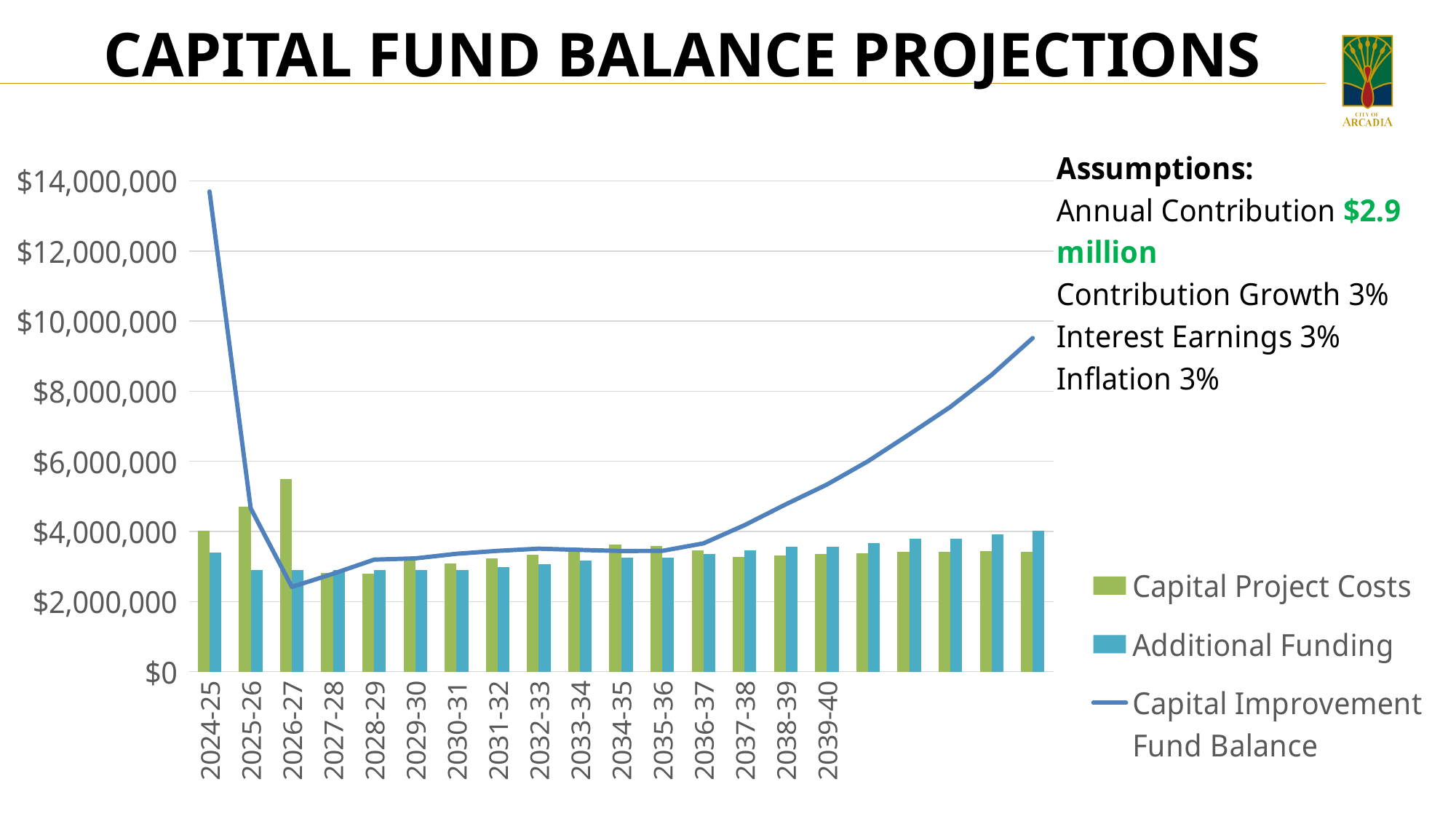
Is the Additional Funding value for 2025-26 greater or less than $4,000,000? less Which series is drawn as a line rather than bars? Capital Improvement Fund Balance Is the Capital Improvement Fund Balance for 2026-27 greater or less than $4,000,000? less How many series does the chart legend list? 3 What is the title of the chart on the slide? Capital Fund Balance Projections Is the Capital Project Costs value for 2026-27 greater or less than $4,000,000? greater What kind of chart is shown on the slide? A combined bar and line chart In 2025-26, which is larger: Capital Project Costs or Additional Funding? Capital Project Costs In which year are Capital Project Costs highest? 2026-27 In which year is the Capital Improvement Fund Balance lowest? 2026-27 Does the Capital Improvement Fund Balance rise or fall from 2036-37 to the end of the projection? Rise